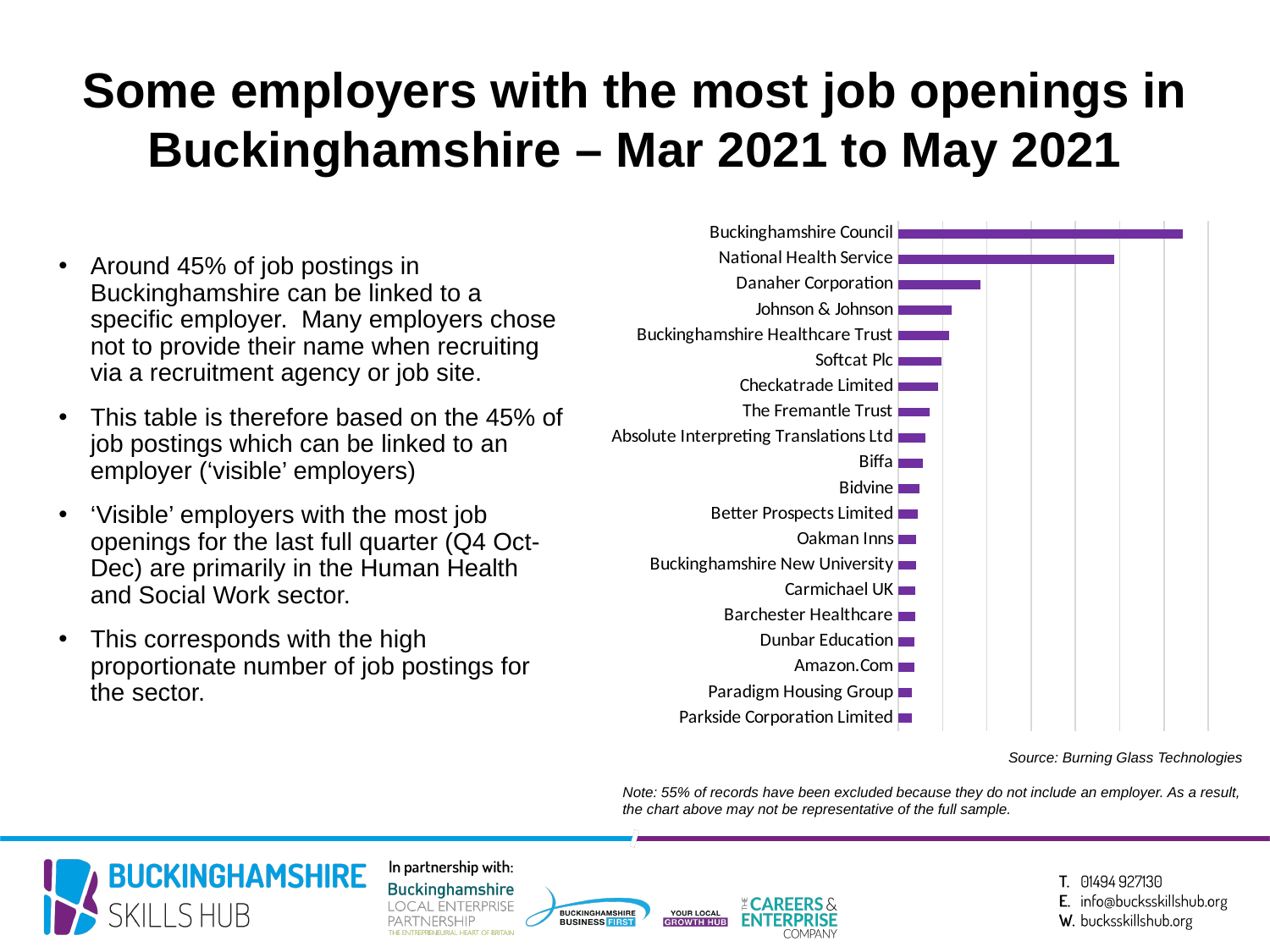
Which has the longer bar, National Health Service or Danaher Corporation? National Health Service Which employer has the longest bar in the chart? Buckinghamshire Council What kind of chart is shown on the slide? Bar chart Which has the longer bar, Buckinghamshire Council or National Health Service? Buckinghamshire Council How many employers are listed in the chart? 20 Which employer has the shortest bar in the chart? Parkside Corporation Limited What source is cited for the chart? Burning Glass Technologies Do the bar lengths increase or decrease going from the top of the chart to the bottom? Decrease Which has the longer bar, Danaher Corporation or Johnson & Johnson? Danaher Corporation Which employer is listed third from the top in the chart? Danaher Corporation